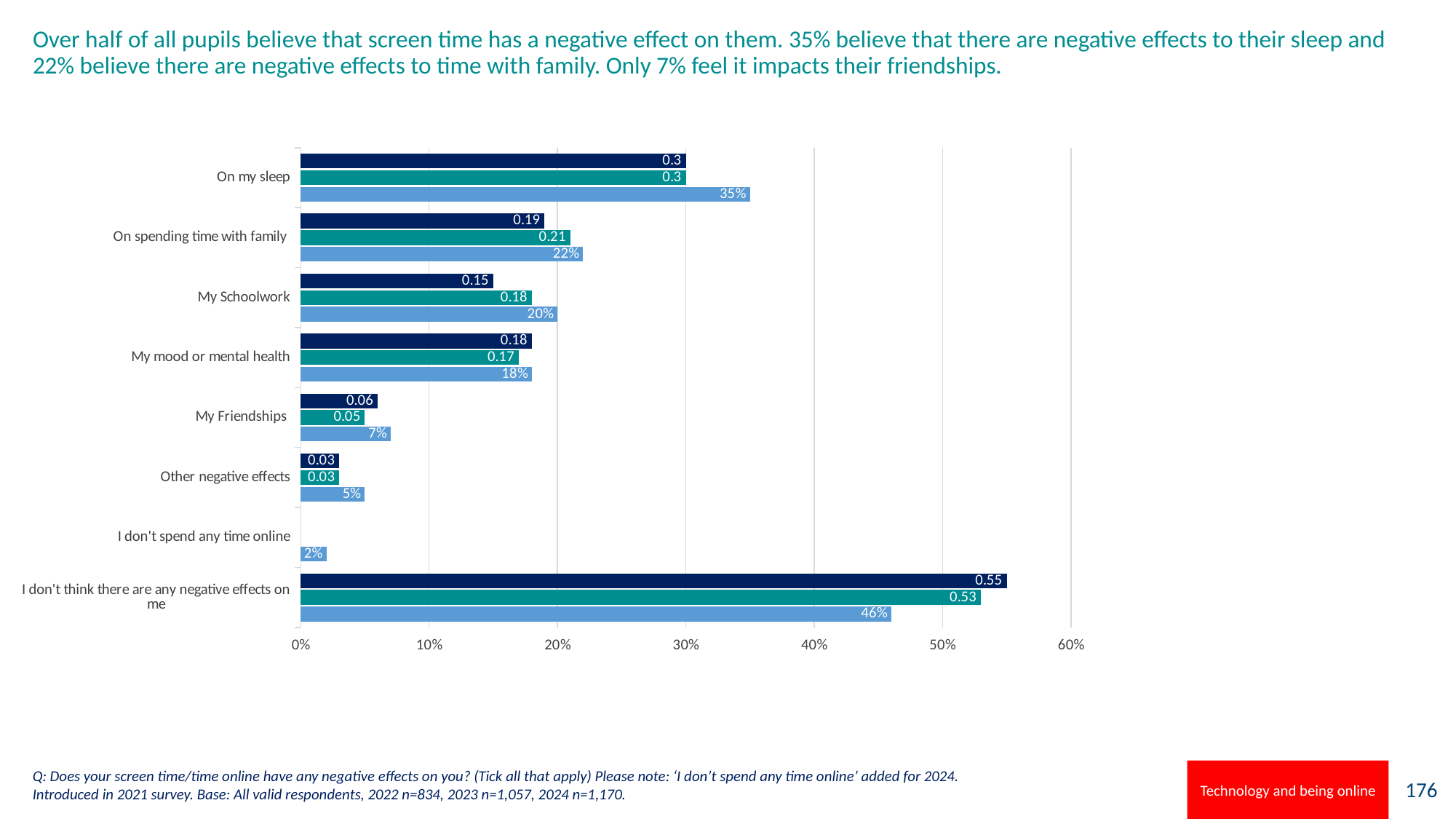
What value is printed on the dark navy bar for "I don't think there are any negative effects on me"? 0.55 Among the categories with a dark navy bar, which has the lowest dark navy value? Other negative effects What value is printed on the light blue bar for "I don't spend any time online"? 2% How many differently coloured bar series are plotted for "On my sleep"? 3 Which category has the highest light blue bar? I don't think there are any negative effects on me Which is larger: the dark navy bar for "My Schoolwork" or the dark navy bar for "My mood or mental health"? My mood or mental health How many categories are listed on the vertical axis of the chart? 8 What value is printed on the teal bar for "On spending time with family"? 0.21 Is the teal bar for "I don't think there are any negative effects on me" greater or less than 50%? greater What is the difference between the light blue values for "On my sleep" and "On spending time with family"? 13% What value is printed on the light blue bar for "On my sleep"? 35% What type of chart is shown on the slide? bar chart